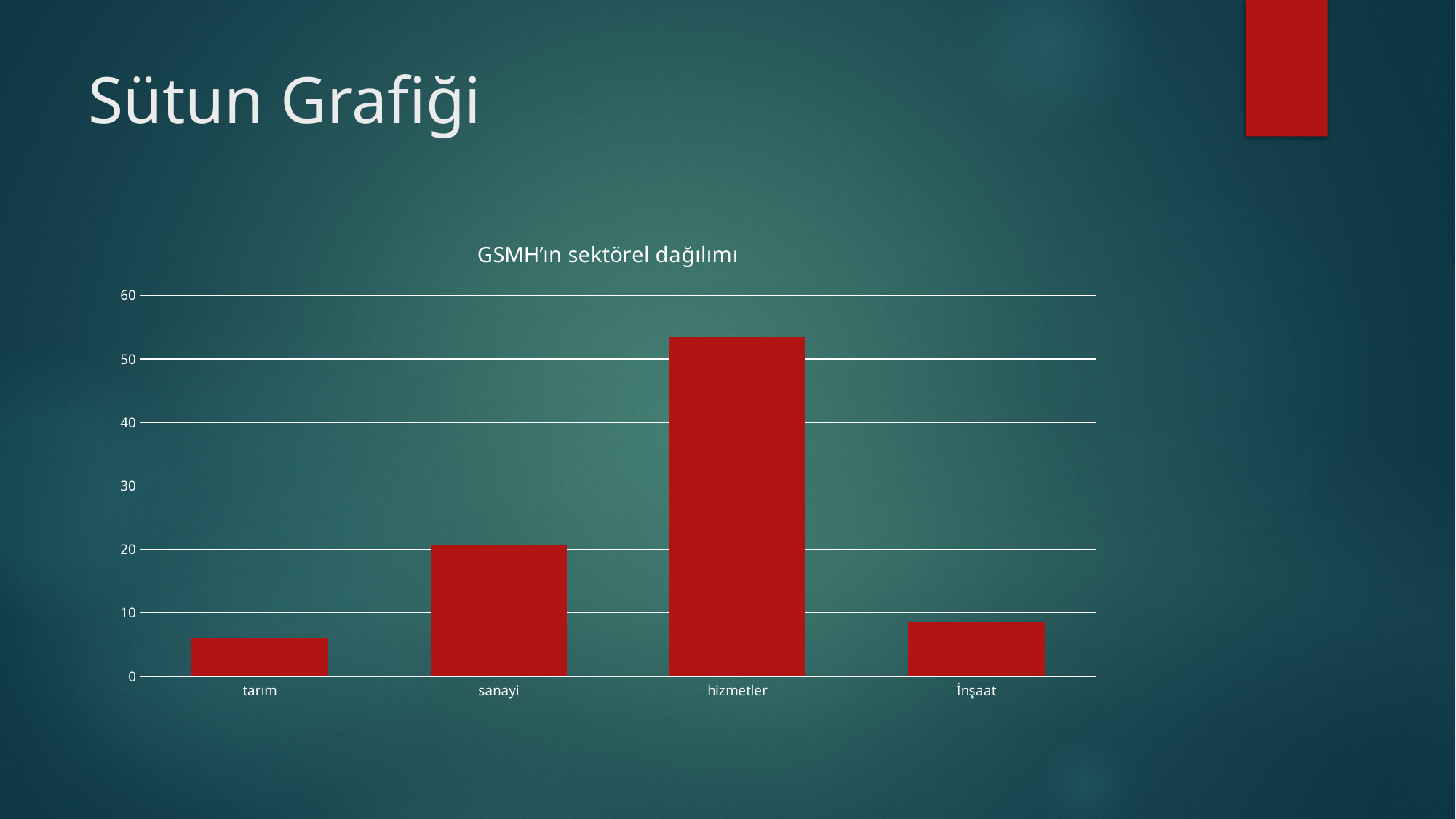
Is the value for tarım greater or less than 10? less Which category has the highest value in the chart? hizmetler What kind of chart is shown on the slide? bar chart Is the value for İnşaat greater or less than 10? less Which is larger, the value for sanayi or the value for İnşaat? sanayi What is the highest value shown on the vertical axis of the chart? 60 Is the value for hizmetler greater or less than 50? greater Which category has the lowest value in the chart? tarım How many categories are shown on the x axis of the chart? 4 What is the title of the chart? GSMH’ın sektörel dağılımı Which is larger, the value for tarım or the value for İnşaat? İnşaat